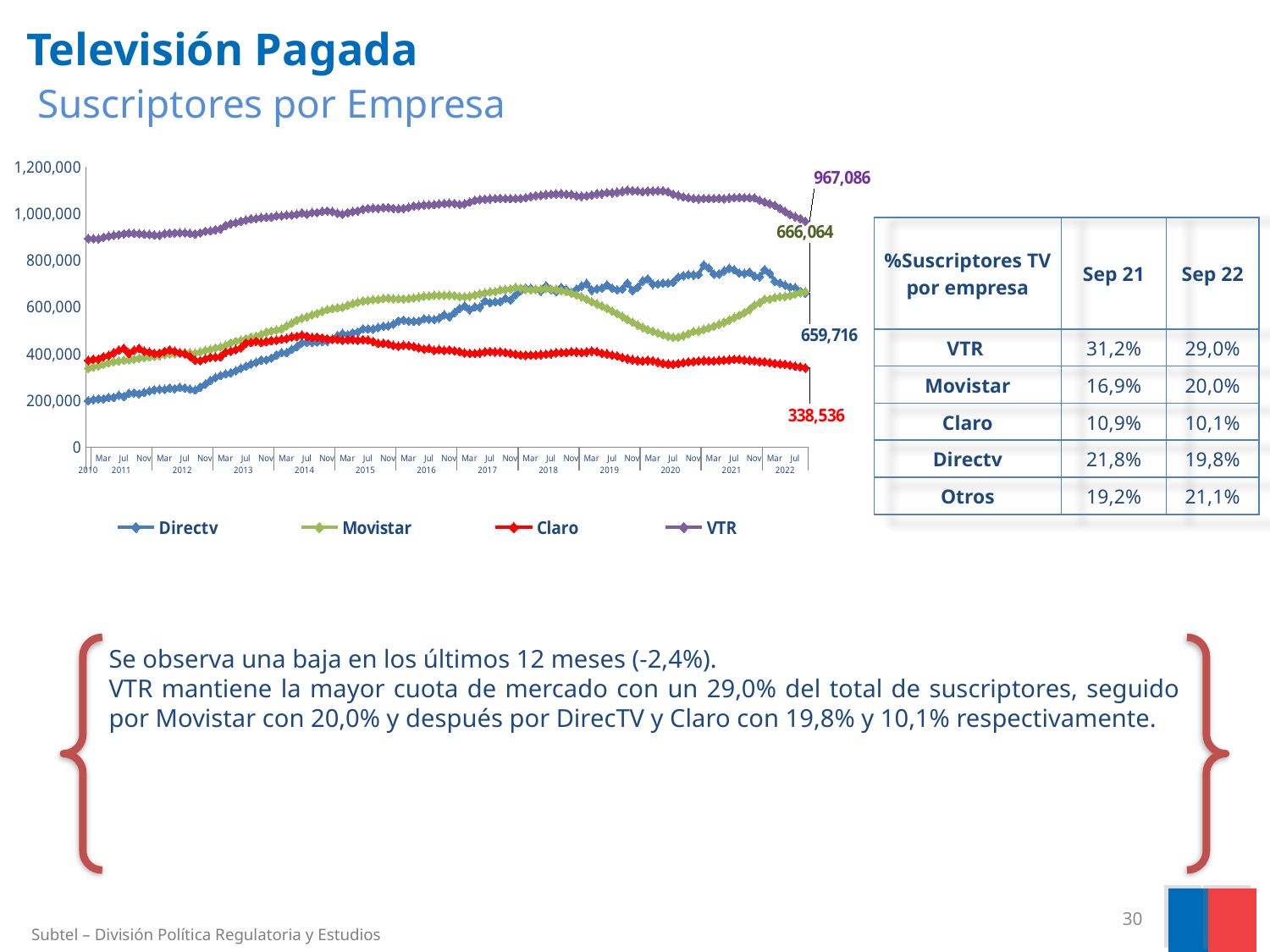
Is the value for VTR at the start of 2010 greater or less than 800,000? greater What is the difference between the final labelled values for VTR and Claro? 628,550 Which colour is used for the VTR series in the chart? Purple What is the final labelled value for Claro on the chart? 338,536 Which company has the highest number of subscribers at the end of the series? VTR What kind of chart is shown on the slide? Line chart How many series does the chart legend list? 4 What is the final labelled value for Movistar on the chart? 666,064 What is the final labelled value for VTR on the chart? 967,086 Which company has the lowest number of subscribers at the end of the series? Claro What is the final labelled value for Directv on the chart? 659,716 Does the Claro line rise or fall from 2014 to 2022? Fall